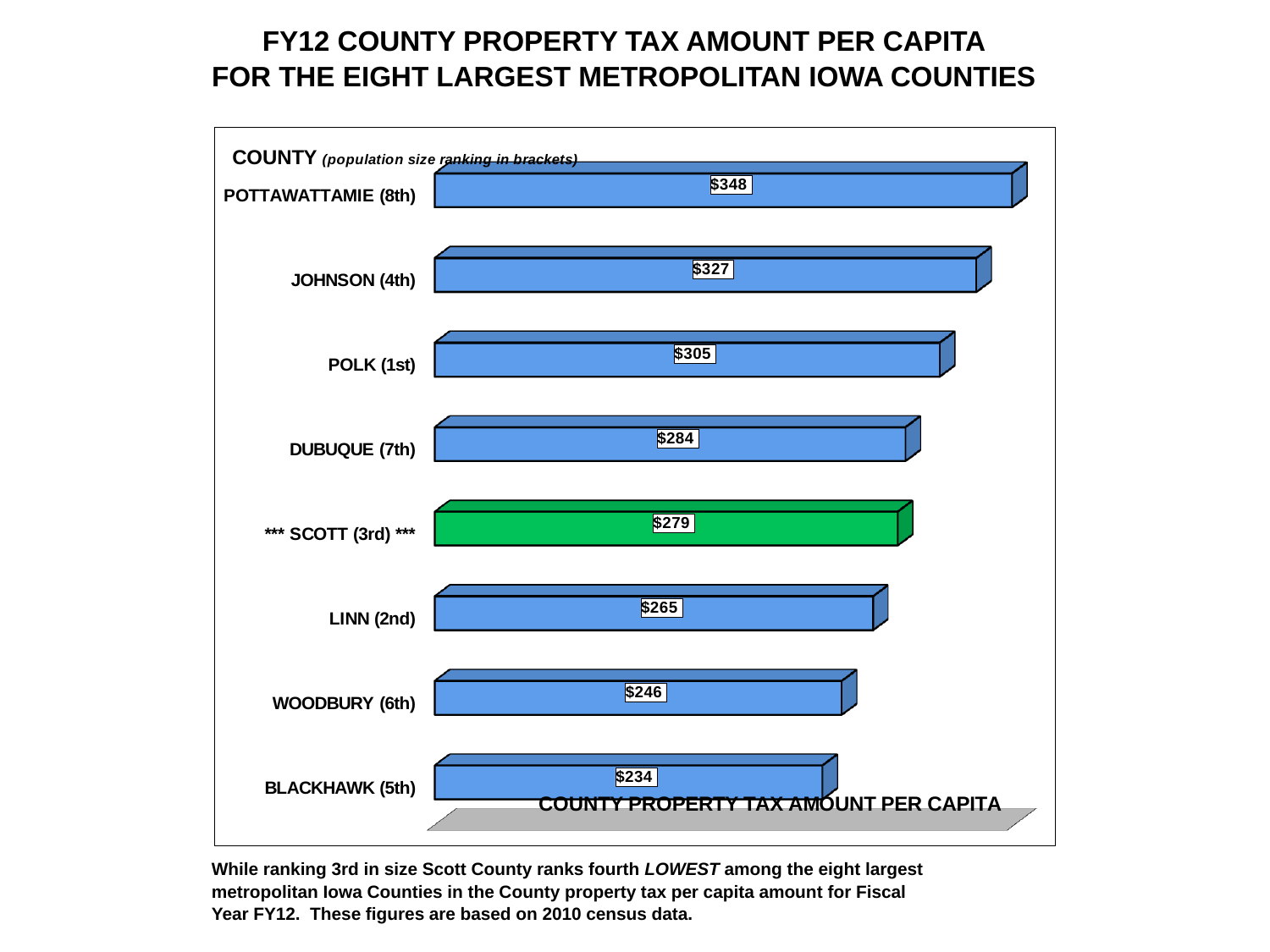
What is the county property tax amount per capita for Linn County? $265 Which county has the lowest property tax amount per capita? Blackhawk What is the county property tax amount per capita for Pottawattamie County? $348 Which has a larger property tax amount per capita, Johnson County or Dubuque County? Johnson Which has a larger property tax amount per capita, Woodbury County or Linn County? Linn What is the county property tax amount per capita for Scott County? $279 Which county's bar is coloured green instead of blue? Scott How many counties are shown in the chart? 8 What is the difference between the per capita amounts for Pottawattamie and Blackhawk counties? $114 Which county has the highest property tax amount per capita? Pottawattamie What kind of chart is shown on the slide? Bar chart What is the difference between the per capita amounts for Polk and Scott counties? $26